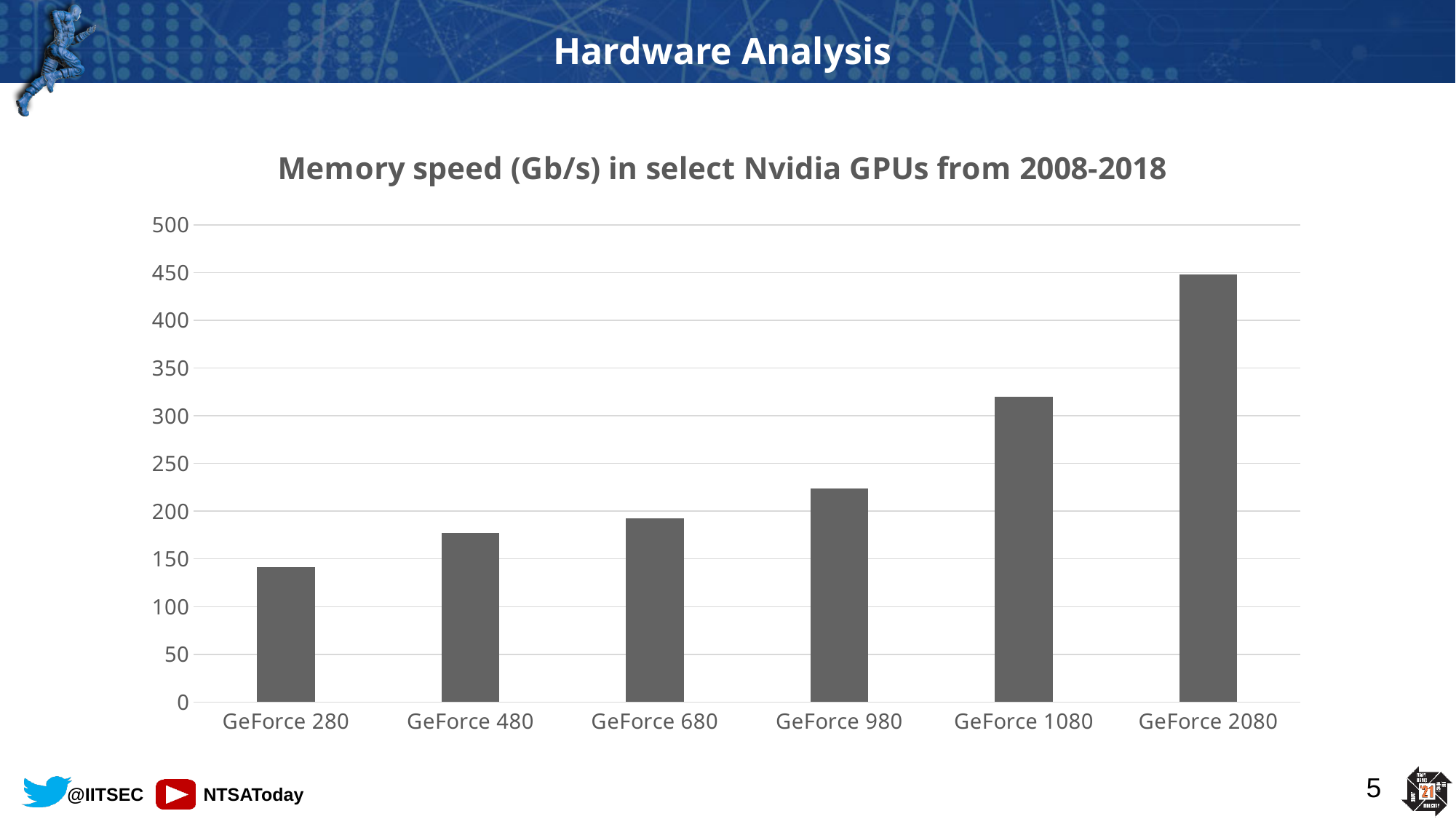
Do the memory speed values rise or fall from GeForce 280 to GeForce 2080 along the x axis? Rise Is the value for GeForce 480 greater or less than 150? greater Is the value for GeForce 1080 greater or less than 300? greater Is the value for GeForce 280 greater or less than 150? less What kind of chart is shown on the slide? Bar chart What is the title of the chart? Memory speed (Gb/s) in select Nvidia GPUs from 2008-2018 Which has the larger memory speed, GeForce 980 or GeForce 1080? GeForce 1080 Which GPU has the lowest memory speed in the chart? GeForce 280 Which GPU has the highest memory speed in the chart? GeForce 2080 How many GPUs are shown on the x axis of the chart? 6